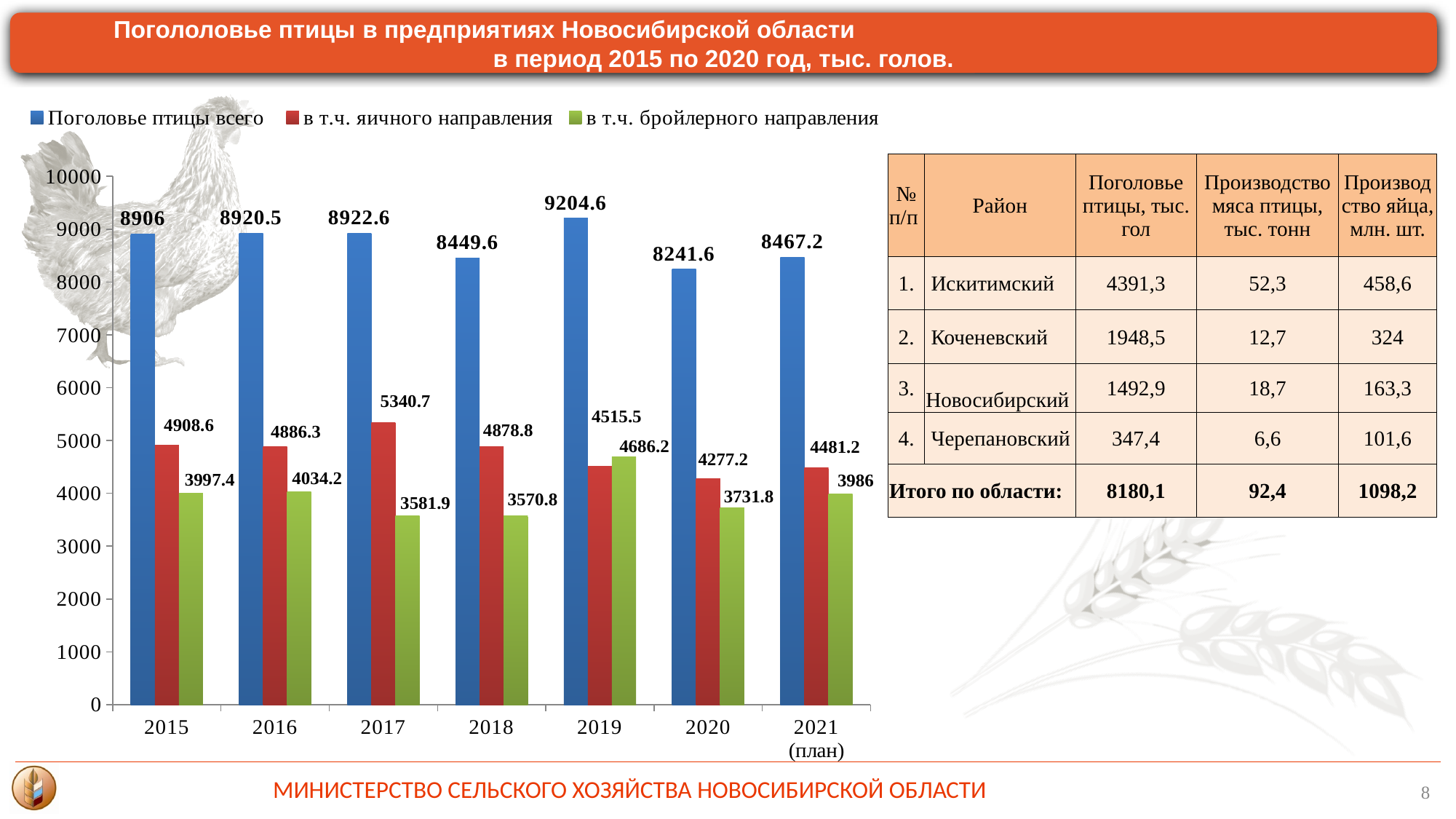
Does 'в т.ч. яичного направления' rise or fall from 2017 to 2020? fall In which year is 'Поголовье птицы всего' the highest? 2019 What is the value of 'Поголовье птицы всего' for 2019? 9204.6 What is the value of 'в т.ч. бройлерного направления' for 2021 (план)? 3986 How many years are shown on the x axis of the chart? 7 How many series does the chart legend list? 3 In which year is 'Поголовье птицы всего' the lowest? 2020 In which year is 'в т.ч. яичного направления' the highest? 2017 What is the difference between 'Поголовье птицы всего' in 2019 and in 2018? 755 Which is larger in 2016: 'в т.ч. яичного направления' or 'в т.ч. бройлерного направления'? в т.ч. яичного направления What is the difference between 'в т.ч. бройлерного направления' in 2019 and in 2020? 954.4 What is the value of 'в т.ч. яичного направления' for 2017? 5340.7